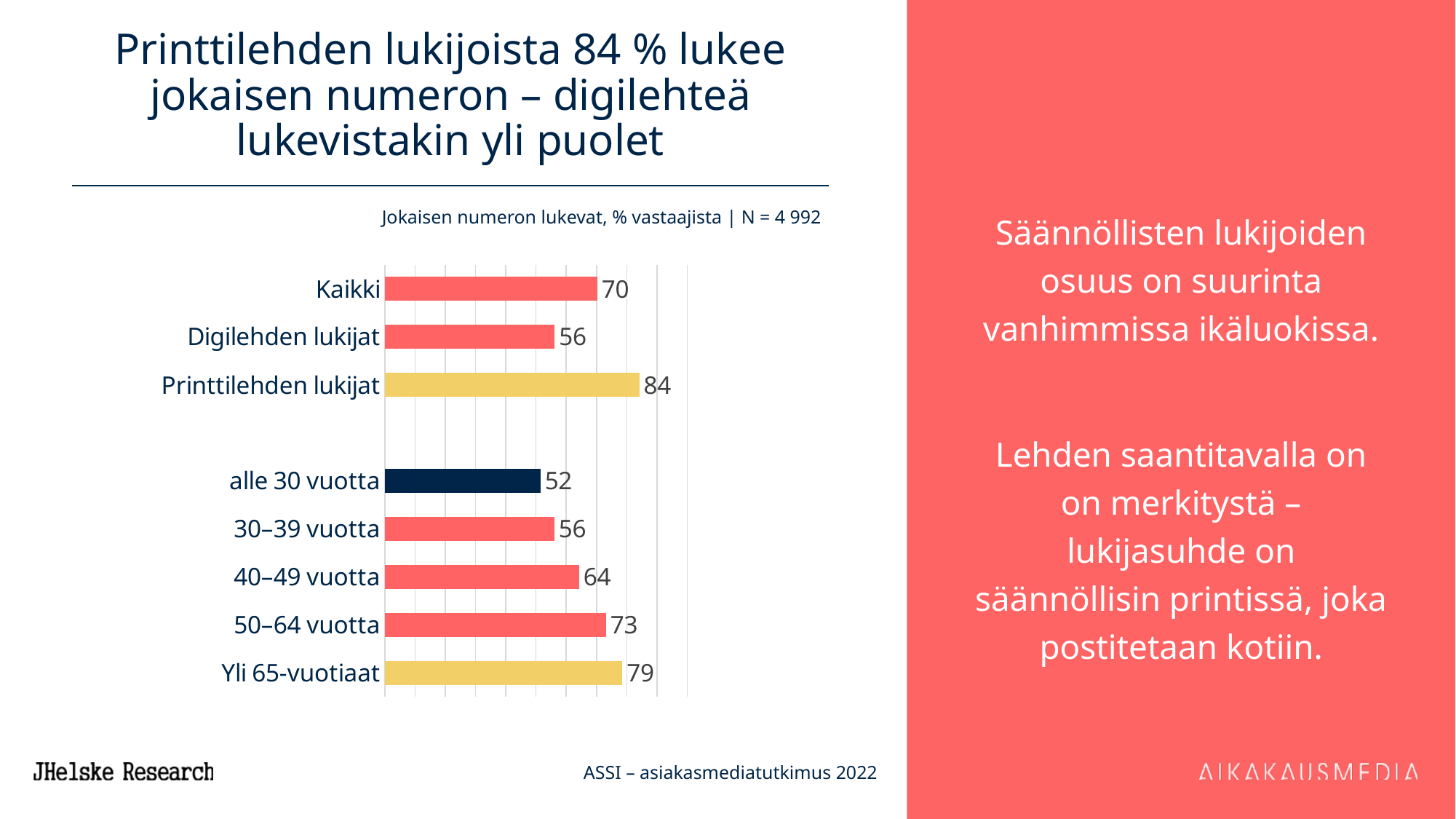
How many categories are plotted in the chart? 8 What kind of chart is shown on the slide? Bar chart Which category has the lowest value? alle 30 vuotta Do the values rise or fall across the age groups from alle 30 vuotta to Yli 65-vuotiaat? Rise What is the value for Printtilehden lukijat? 84 What is the value for Kaikki? 70 What is the difference between the values for Printtilehden lukijat and Digilehden lukijat? 28 What is the value for Digilehden lukijat? 56 Which is larger, the value for 50–64 vuotta or the value for 40–49 vuotta? 50–64 vuotta What is the value for Yli 65-vuotiaat? 79 What is the value for alle 30 vuotta? 52 Which category has the highest value? Printtilehden lukijat